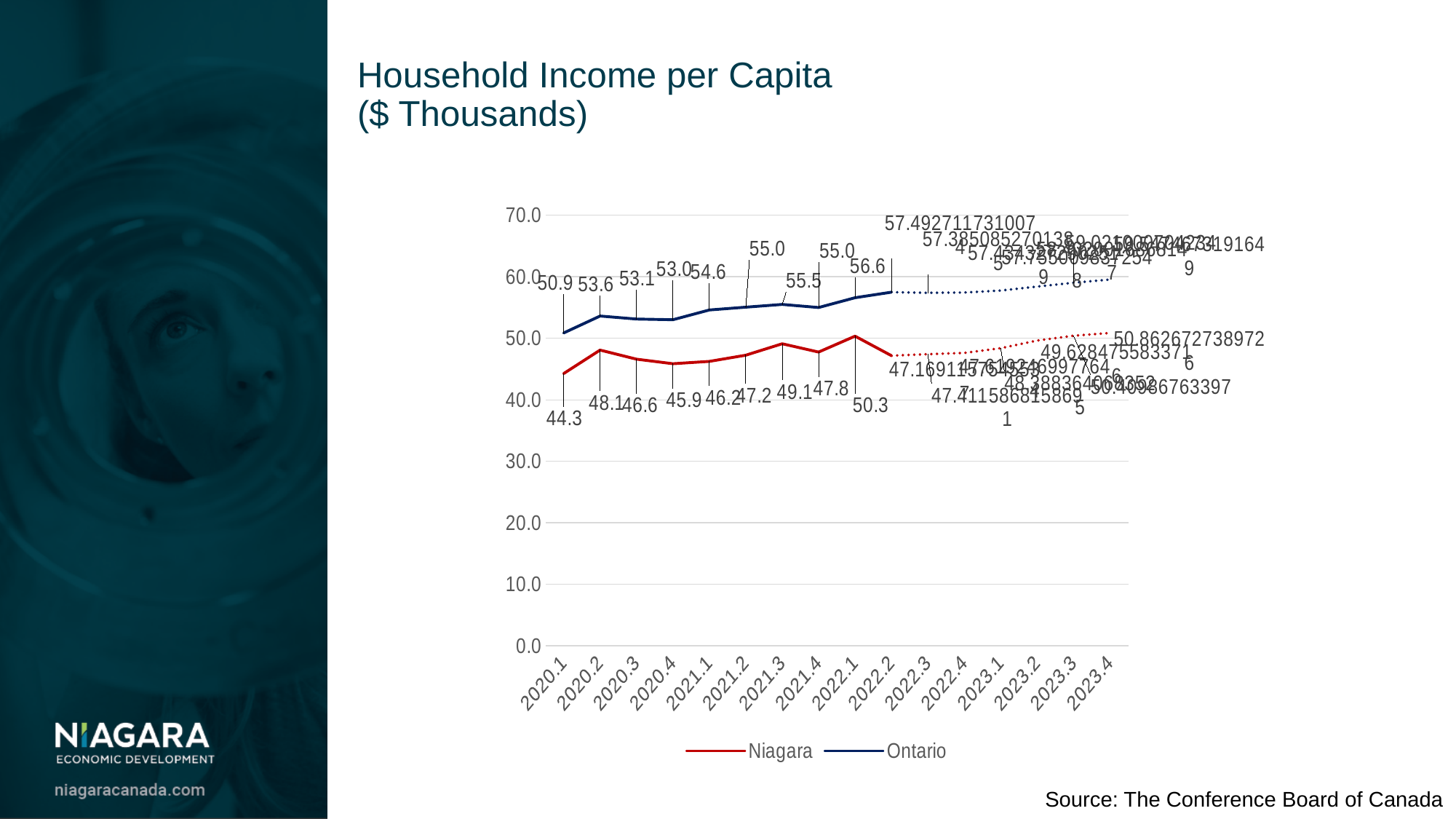
Is the Ontario value for 2023.4 greater or less than 50.0? greater What is the Niagara value for 2020.1? 44.3 Does the Ontario line generally rise or fall from 2020.1 to 2022.1? rise How many series does the legend list? 2 Which series has the higher value in 2021.1, Niagara or Ontario? Ontario What is the Ontario value for 2020.4? 53.0 How many time periods are shown on the x axis? 16 What is the title of the chart? Household Income per Capita ($ Thousands) What is the Niagara value for 2021.3? 49.1 What is the Ontario value for 2022.1? 56.6 What type of chart is shown on the slide? line chart What is the difference between the Ontario and Niagara values for 2020.1? 6.6